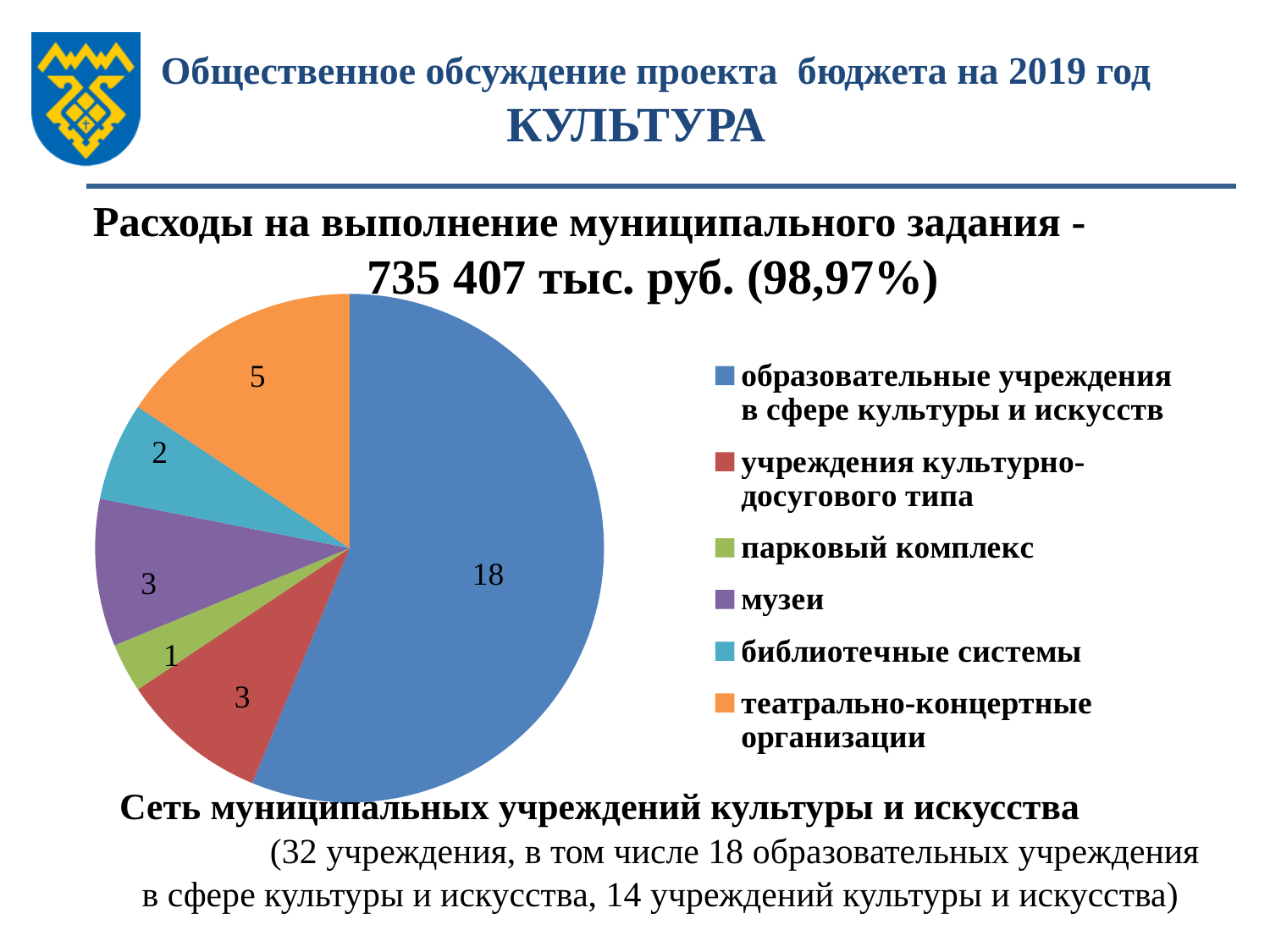
Which category has the smallest slice of the pie? парковый комплекс What is the value for библиотечные системы? 2 What is the difference between the value for образовательные учреждения в сфере культуры и искусств and the value for театрально-концертные организации? 13 What is the total of all the values shown in the pie chart? 32 How many slices does the pie chart have? 6 How many entries does the legend of the pie chart list? 6 What is the value for образовательные учреждения в сфере культуры и искусств? 18 Which is larger: the value for театрально-концертные организации or the value for библиотечные системы? театрально-концертные организации Which category has the largest slice of the pie? образовательные учреждения в сфере культуры и искусств What is the value for театрально-концертные организации? 5 What is the value for музеи? 3 What kind of chart is shown on the slide? pie chart